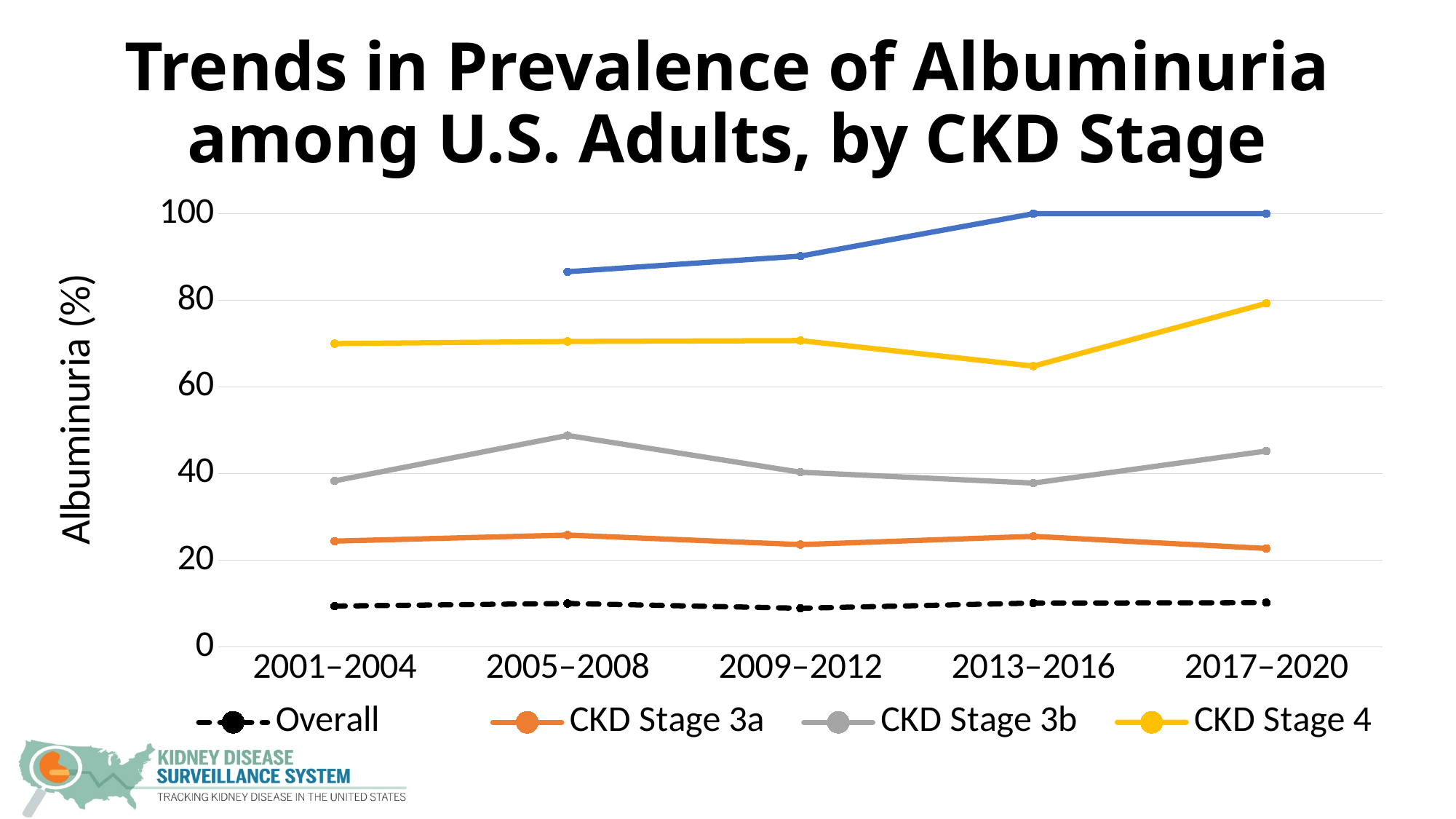
Is the value for CKD Stage 3a in 2017–2020 greater or less than 40? less Is the value for Overall in 2001–2004 greater or less than 20? less Is the value for CKD Stage 4 in 2017–2020 greater or less than 60? greater What kind of chart is shown on the slide? line chart In 2013–2016, which is larger: the value for CKD Stage 4 or the value for CKD Stage 3b? CKD Stage 4 In which time period is the CKD Stage 4 value highest? 2017–2020 How many series does the legend list? 4 How many time periods are shown on the x axis? 5 In which time period is the CKD Stage 4 value lowest? 2013–2016 In 2009–2012, which is larger: the value for Overall or the value for CKD Stage 3a? CKD Stage 3a What is the label of the y axis? Albuminuria (%)